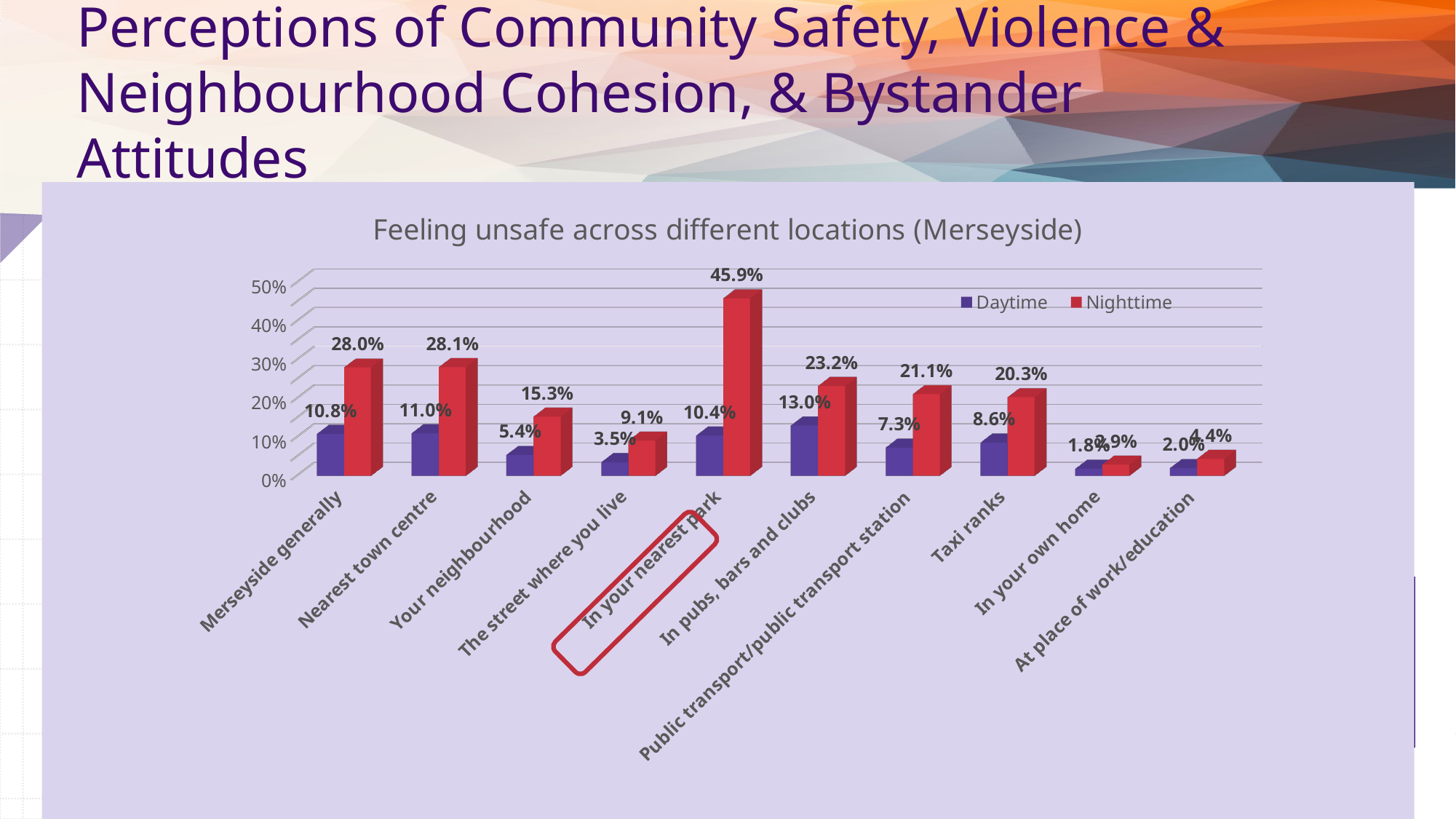
How many locations are shown on the x axis? 10 How many series does the legend list? 2 What is the Daytime value for 'In pubs, bars and clubs'? 13.0% What type of chart is shown on the slide? Bar chart What is the difference between the Nighttime and Daytime values for 'Your neighbourhood'? 9.9% What is the Nighttime value for 'In your nearest park'? 45.9% Which location has the highest Daytime value? In pubs, bars and clubs What is the Nighttime value for 'Taxi ranks'? 20.3% Which location has the lowest Daytime value? In your own home What is the Daytime value for 'The street where you live'? 3.5% Which is larger: the Nighttime value for 'Public transport/public transport station' or the Nighttime value for 'Taxi ranks'? Public transport/public transport station Which location has the highest Nighttime value? In your nearest park